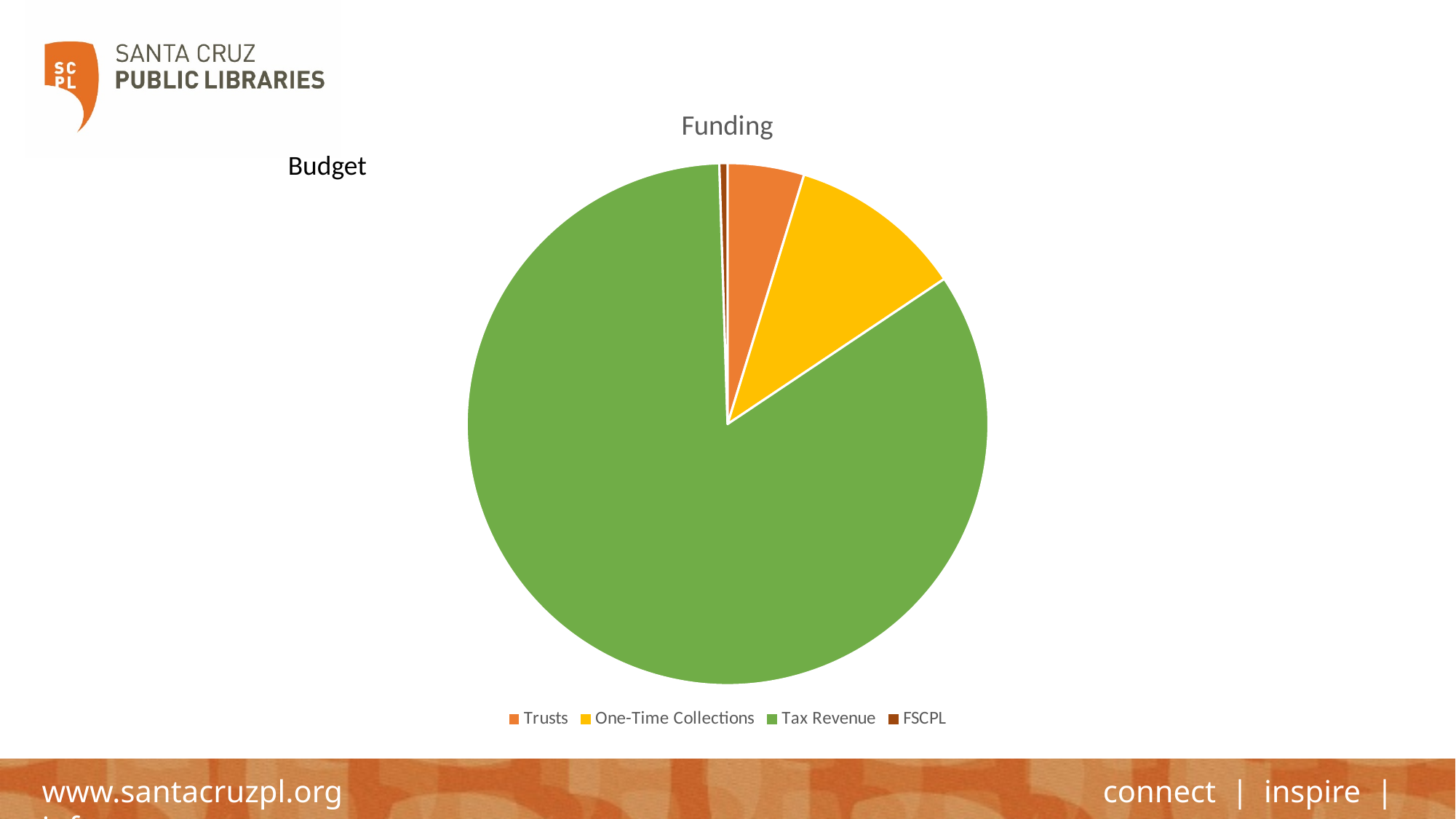
What is the title of the chart? Funding Which category has the smallest slice in the Funding chart? FSCPL What kind of chart is shown on the slide? pie chart Which category is shown in yellow in the Funding chart? One-Time Collections Which category has the largest slice in the Funding chart? Tax Revenue What colour is the Tax Revenue slice in the Funding chart? green Which slice is larger in the Funding chart, Tax Revenue or One-Time Collections? Tax Revenue How many categories does the legend of the Funding chart list? 4 Which slice is larger in the Funding chart, Trusts or FSCPL? Trusts Which slice is larger in the Funding chart, Trusts or One-Time Collections? One-Time Collections